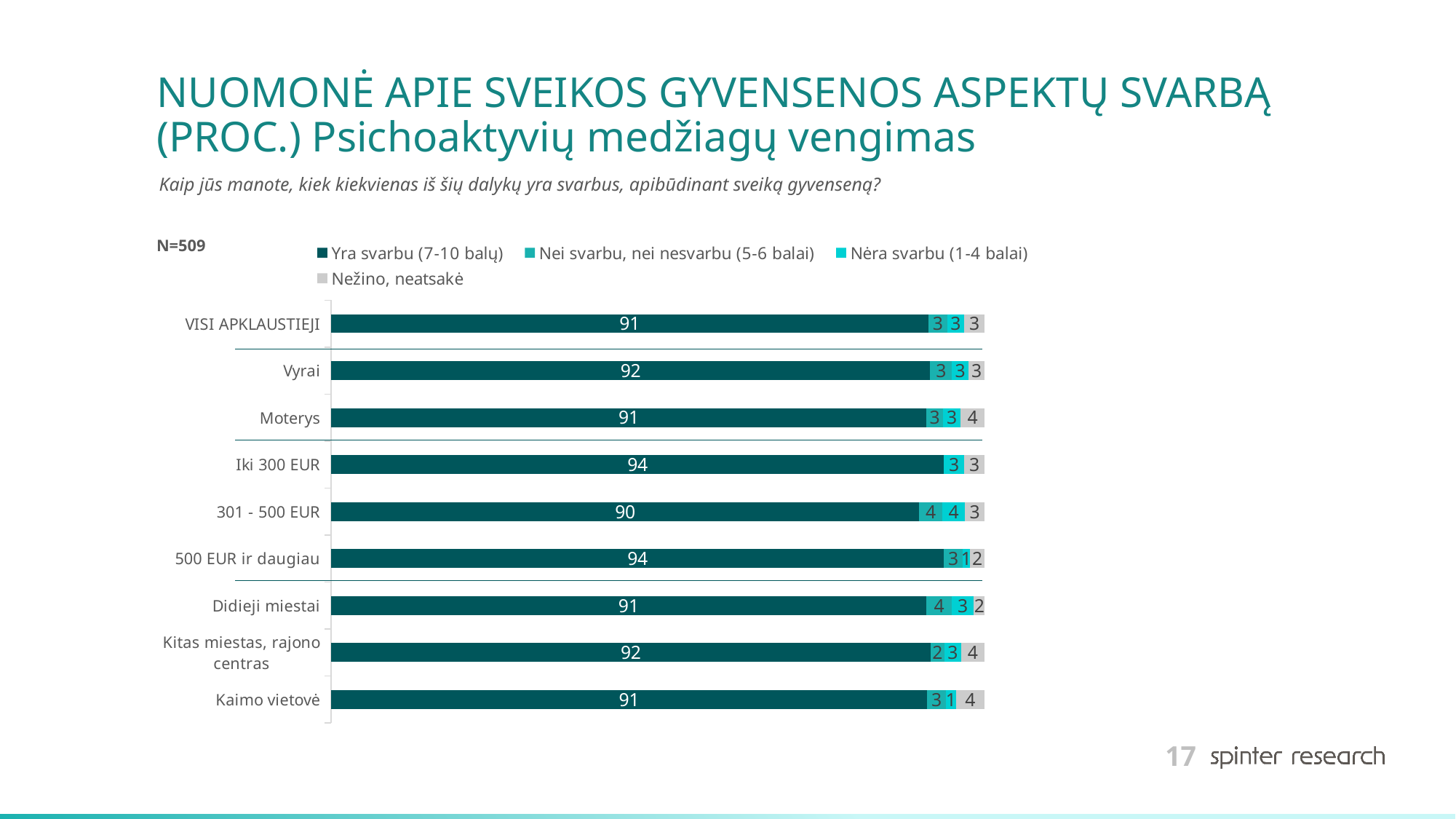
How many categories are shown on the chart? 9 How many series does the legend list? 4 What is the value of "Yra svarbu (7-10 balų)" for VISI APKLAUSTIEJI? 91 Which category has the lowest value for "Yra svarbu (7-10 balų)"? 301 - 500 EUR What kind of chart is shown on the slide? Stacked bar chart What is the value of "Nežino, neatsakė" for Kaimo vietovė? 4 What is the total of the stacked bar for VISI APKLAUSTIEJI? 100 What is the difference between the "Yra svarbu (7-10 balų)" values for Iki 300 EUR and 301 - 500 EUR? 4 Which has a higher "Yra svarbu (7-10 balų)" value, Vyrai or Moterys? Vyrai What sample size (N) is shown on the slide? N=509 What is the value of "Yra svarbu (7-10 balų)" for 301 - 500 EUR? 90 What is the value of "Yra svarbu (7-10 balų)" for Kitas miestas, rajono centras? 92